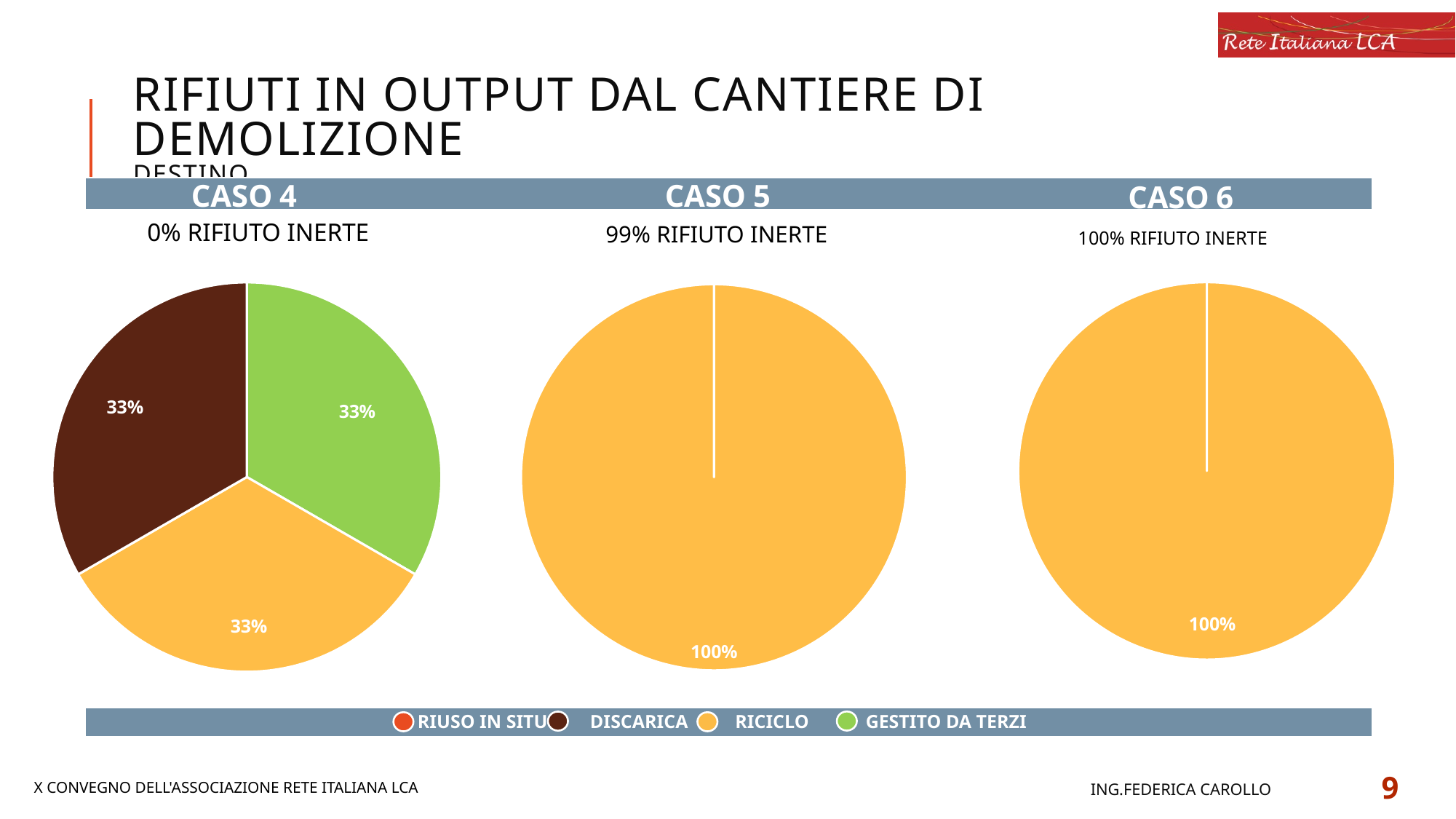
Which category makes up the entire CASO 5 pie chart? RICICLO Which legend entry is shown in green? GESTITO DA TERZI What kind of chart is used for CASO 4? pie chart What percentage of inert waste is stated above the CASO 5 chart? 99% In the CASO 4 chart, what share does GESTITO DA TERZI have? 33% How many entries does the shared legend list? 4 In the CASO 5 chart, what share does RICICLO have? 100% In the CASO 4 chart, what share does DISCARICA have? 33% How many slices does the CASO 6 pie chart have? 1 How many slices does the CASO 4 pie chart have? 3